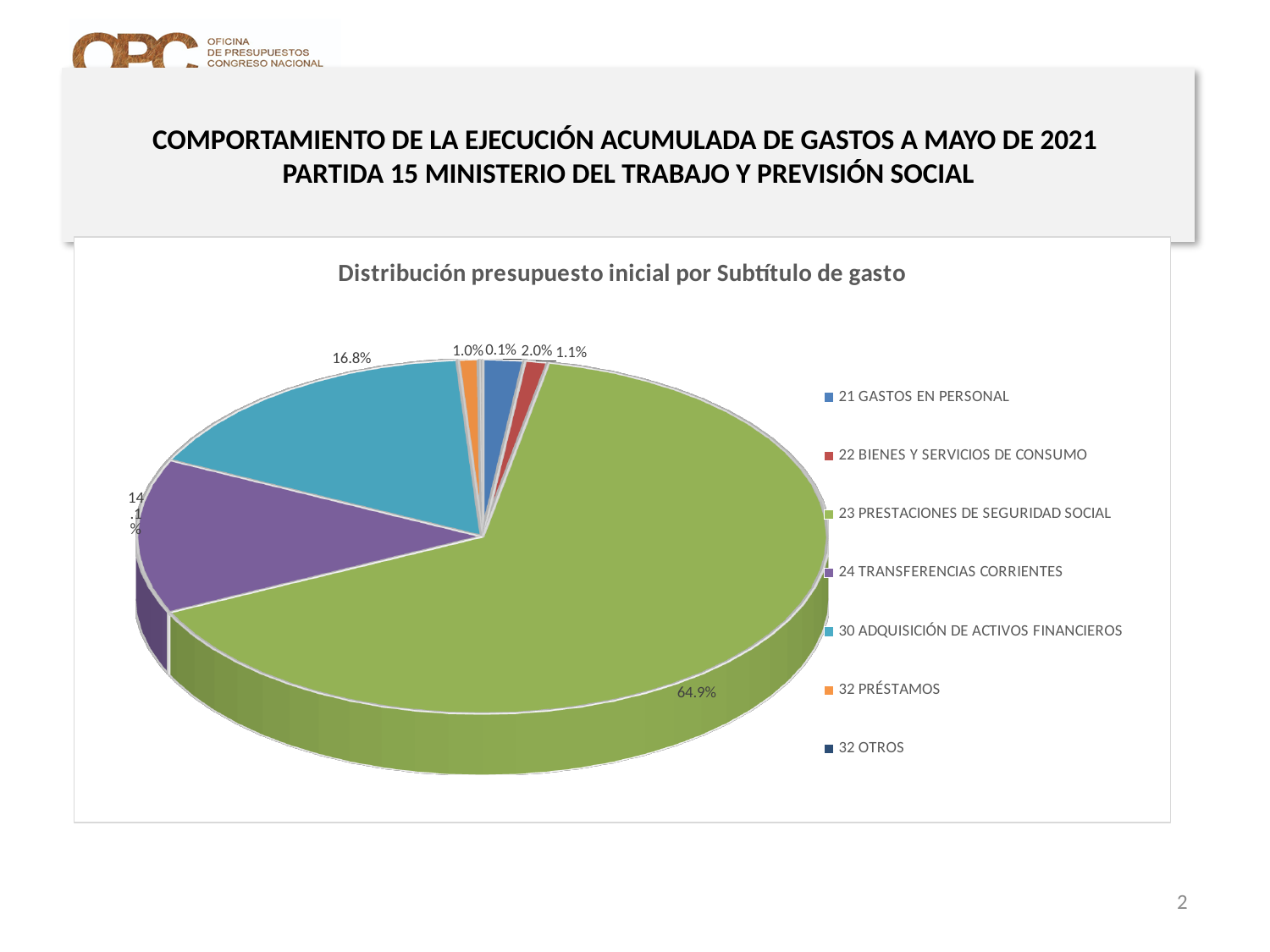
Which category has the smallest share of the pie? 32 OTROS What share of the pie does 23 PRESTACIONES DE SEGURIDAD SOCIAL have? 64.9% What share of the pie does 24 TRANSFERENCIAS CORRIENTES have? 14.1% What share of the pie does 32 PRÉSTAMOS have? 1.0% What is the difference in percentage points between 23 PRESTACIONES DE SEGURIDAD SOCIAL and 30 ADQUISICIÓN DE ACTIVOS FINANCIEROS? 48.1 What is the title of the chart? Distribución presupuesto inicial por Subtítulo de gasto How many categories does the legend list? 7 Which category has the largest share of the pie? 23 PRESTACIONES DE SEGURIDAD SOCIAL Which has a larger share, 30 ADQUISICIÓN DE ACTIVOS FINANCIEROS or 24 TRANSFERENCIAS CORRIENTES? 30 ADQUISICIÓN DE ACTIVOS FINANCIEROS What kind of chart is shown on the slide? Pie chart